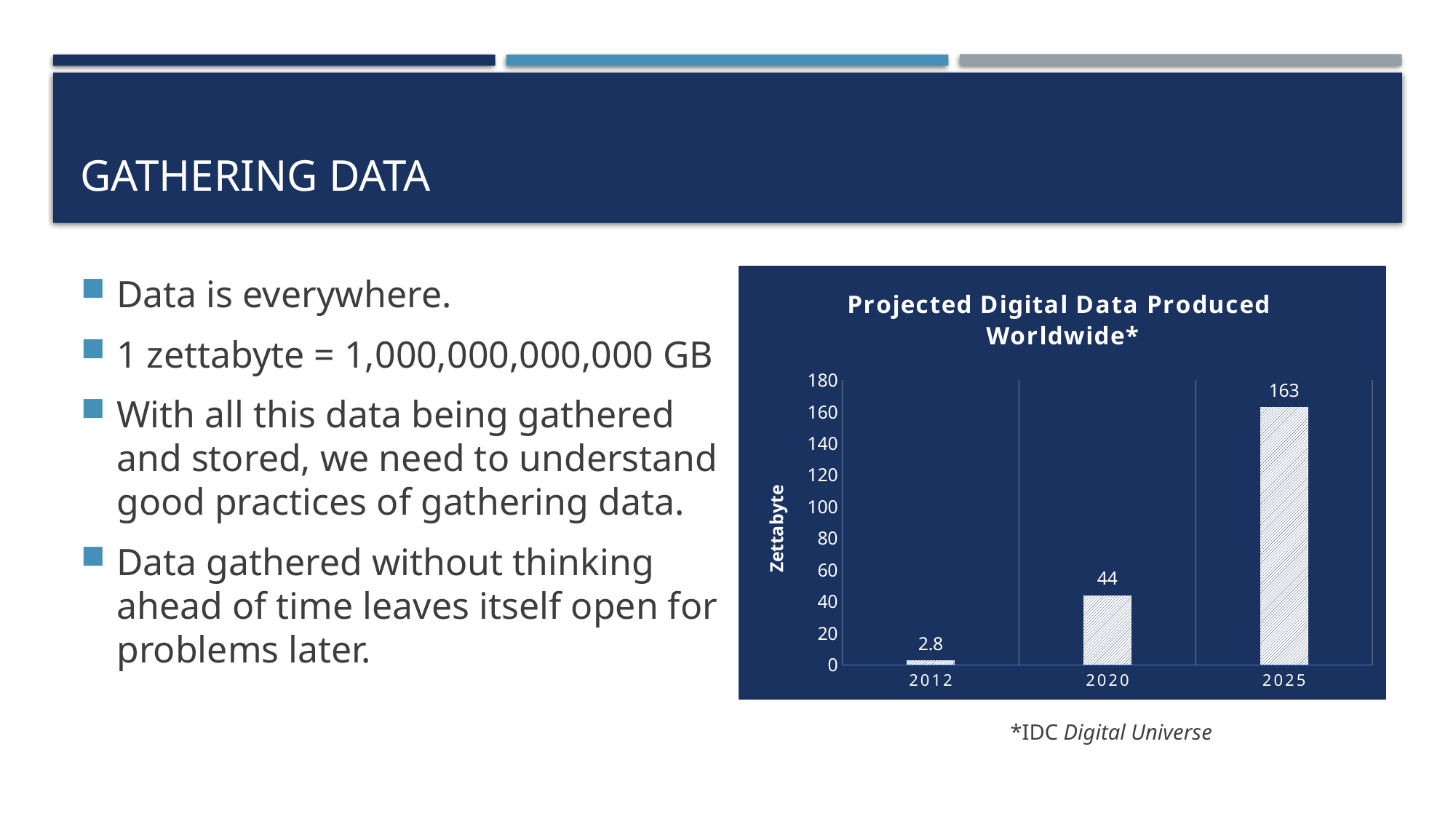
What is the value shown for 2020 in the chart? 44 Is the value for 2025 greater or less than 140? greater What kind of chart is shown on the slide? bar chart Which year has the highest projected digital data produced? 2025 What is the projected digital data produced worldwide in 2025? 163 What is the difference between the values for 2025 and 2020? 119 Which is larger, the value for 2020 or the value for 2012? 2020 How many years are shown on the x axis of the chart? 3 What is the difference between the values for 2020 and 2012? 41.2 What is the value shown for 2012 in the chart? 2.8 What is the label on the y axis of the chart? Zettabyte Which year has the lowest projected digital data produced? 2012